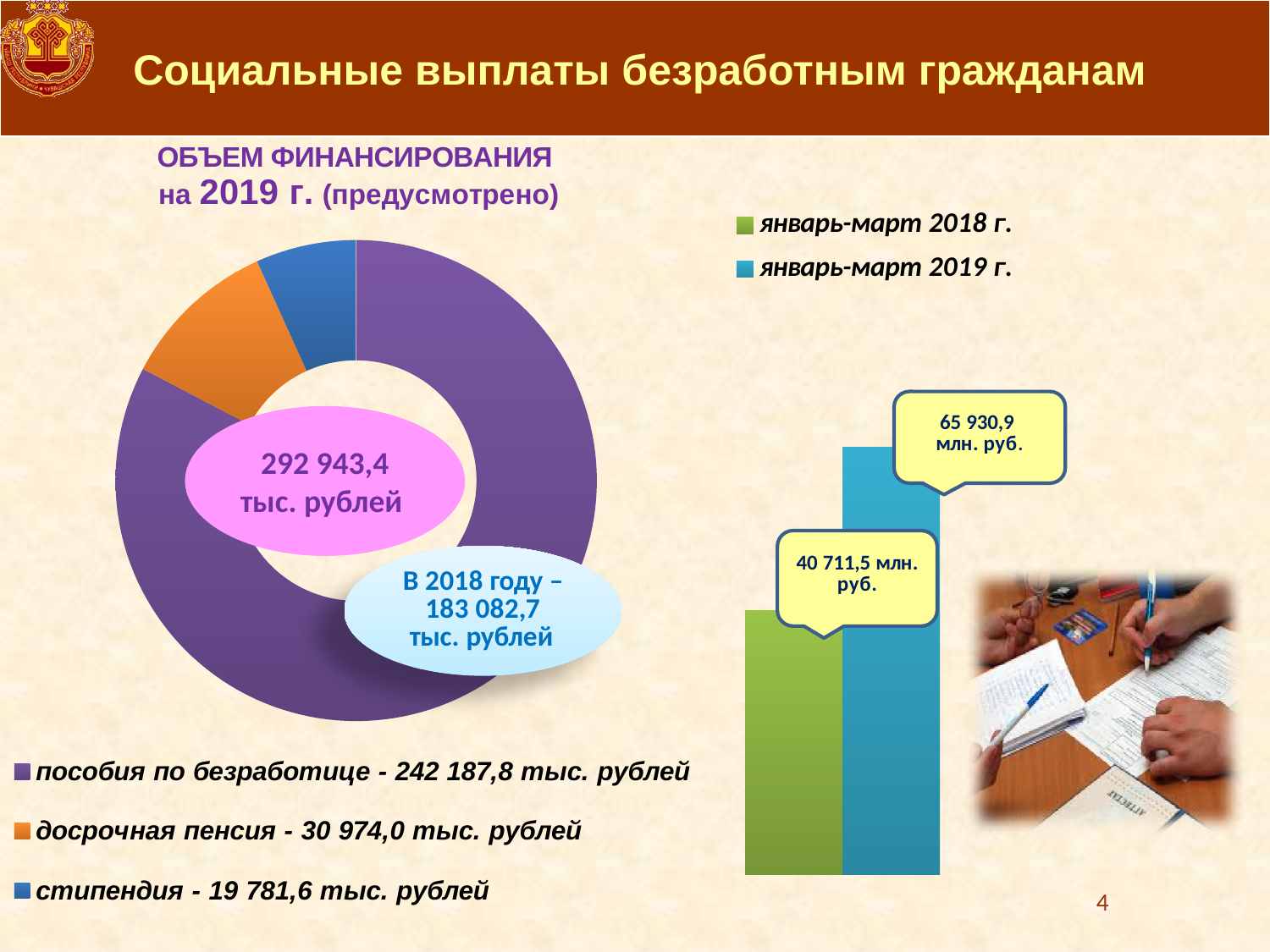
On the doughnut chart on the left, what is the difference between пособия по безработице and досрочная пенсия? 211 213,8 тыс. рублей On the bar chart on the right, what is the value for январь-март 2019 г.? 65 930,9 млн. руб. On the bar chart on the right, how many series does the legend list? 2 On the doughnut chart on the left, which category has the smallest value? стипендия On the doughnut chart on the left, what is the total amount shown in the centre? 292 943,4 тыс. рублей On the doughnut chart on the left, which category has the largest value? пособия по безработице On the doughnut chart on the left, what is the value for стипендия? 19 781,6 тыс. рублей On the bar chart on the right, what is the value for январь-март 2018 г.? 40 711,5 млн. руб. On the doughnut chart on the left, how many categories are shown in the legend? 3 On the bar chart on the right, which period has the larger value, январь-март 2018 г. or январь-март 2019 г.? январь-март 2019 г. On the bar chart on the right, what is the difference between the 2019 and 2018 values? 25 219,4 млн. руб. On the doughnut chart on the left, what is the value for пособия по безработице? 242 187,8 тыс. рублей